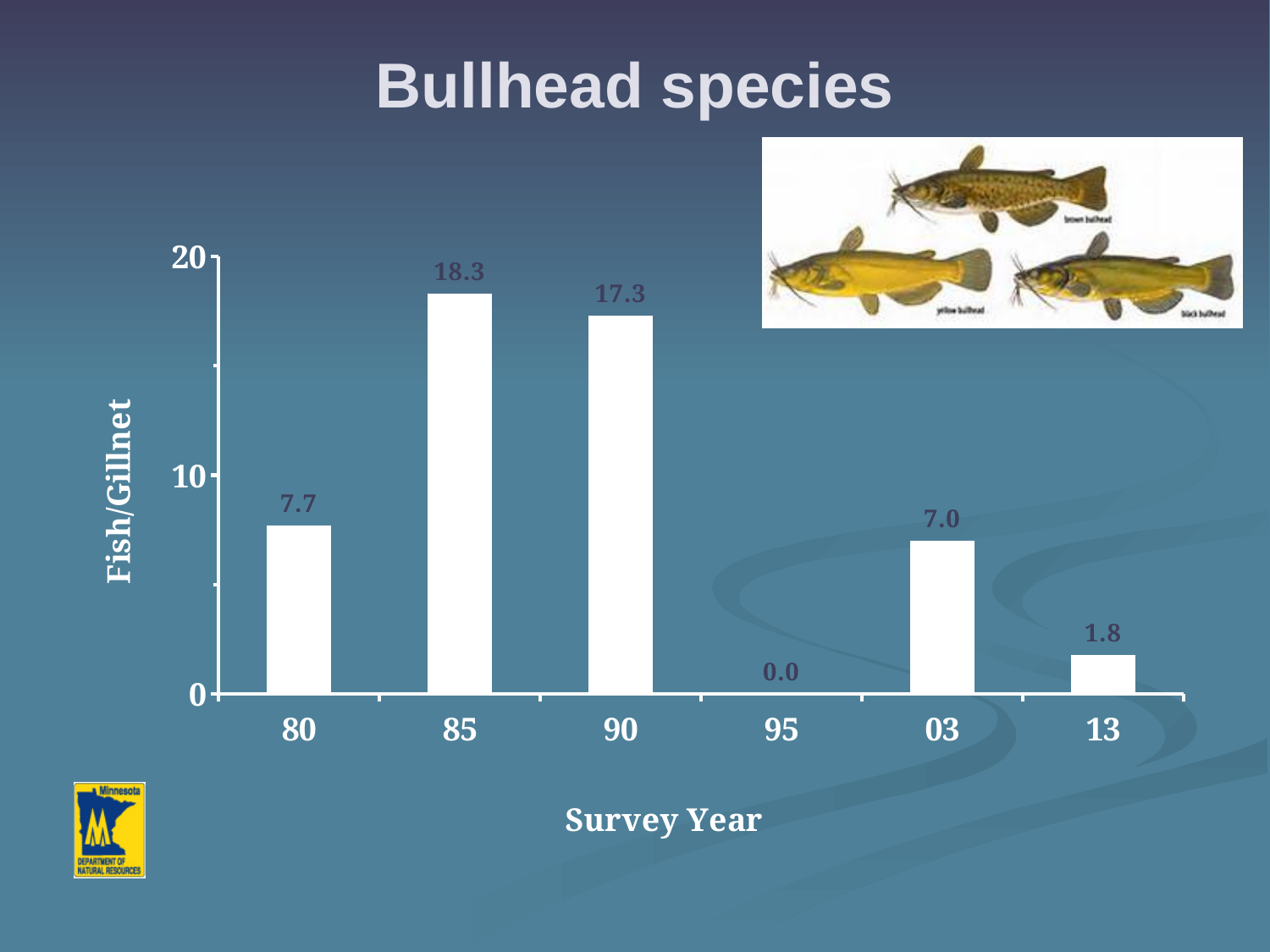
What kind of chart is shown on the slide? bar chart Which survey year has the highest Fish/Gillnet value? 85 What is the label of the y axis? Fish/Gillnet What is the Fish/Gillnet value for survey year 95? 0.0 What is the difference between the Fish/Gillnet values for survey years 85 and 90? 1.0 Which survey year has a larger Fish/Gillnet value, 80 or 03? 80 What is the difference between the Fish/Gillnet values for survey years 80 and 13? 5.9 Is the Fish/Gillnet value for survey year 90 greater or less than 10? greater How many survey years are shown on the x axis? 6 Which survey year has the lowest Fish/Gillnet value? 95 What is the Fish/Gillnet value for survey year 85? 18.3 What is the Fish/Gillnet value for survey year 03? 7.0